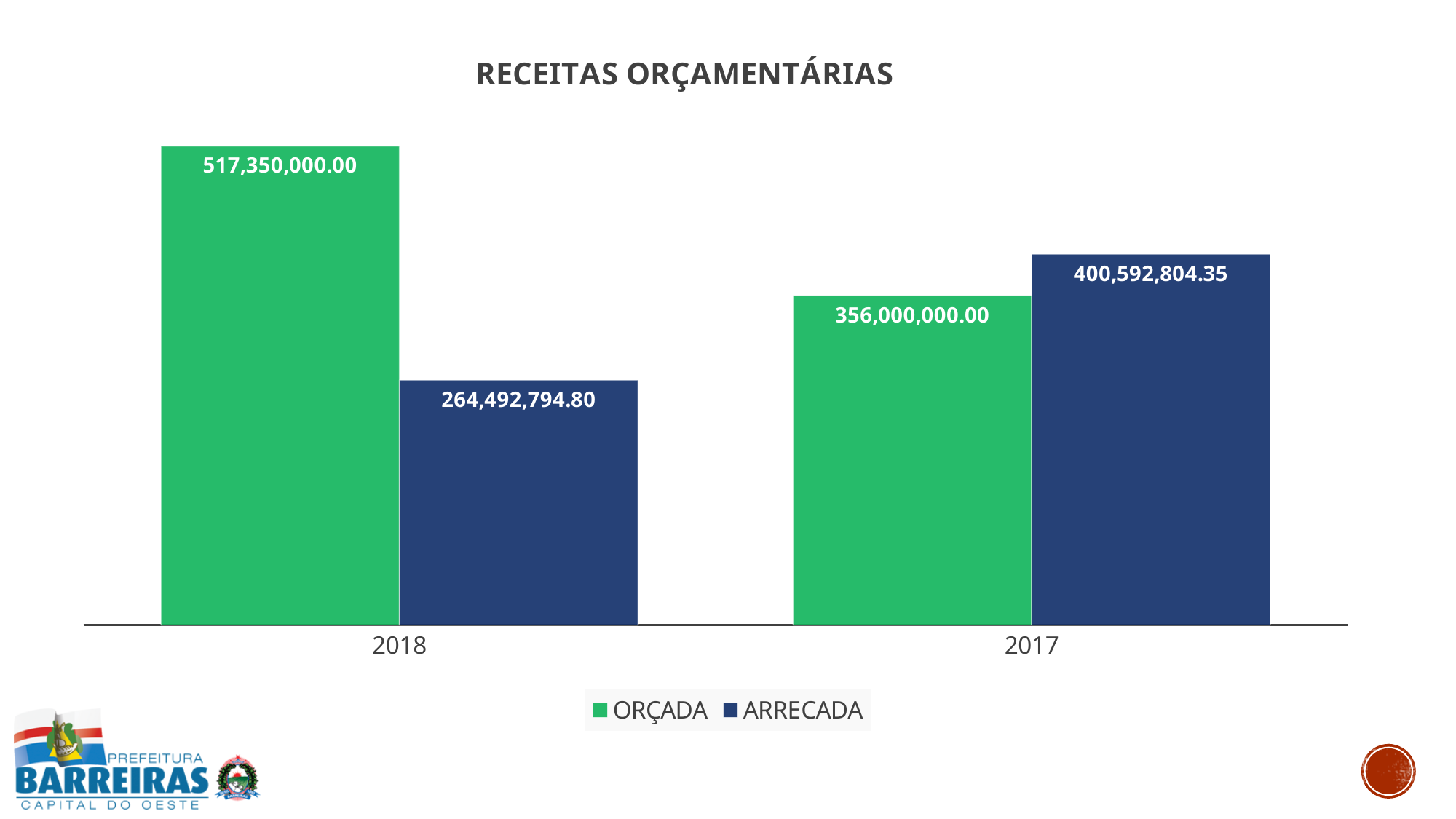
How many series does the legend list? 2 What is the title of the chart? RECEITAS ORÇAMENTÁRIAS What is the ORÇADA value for 2017? 356,000,000.00 Which bar has the lowest value on the chart? ARRECADA 2018 What is the ARRECADA value for 2018? 264,492,794.80 Which bar has the highest value on the chart? ORÇADA 2018 What is the difference between the ARRECADA and ORÇADA values for 2017? 44,592,804.35 What is the ORÇADA value for 2018? 517,350,000.00 What is the difference between the ORÇADA and ARRECADA values for 2018? 252,857,205.20 For 2017, which is larger, ORÇADA or ARRECADA? ARRECADA What kind of chart is shown on the slide? Bar chart What is the ARRECADA value for 2017? 400,592,804.35